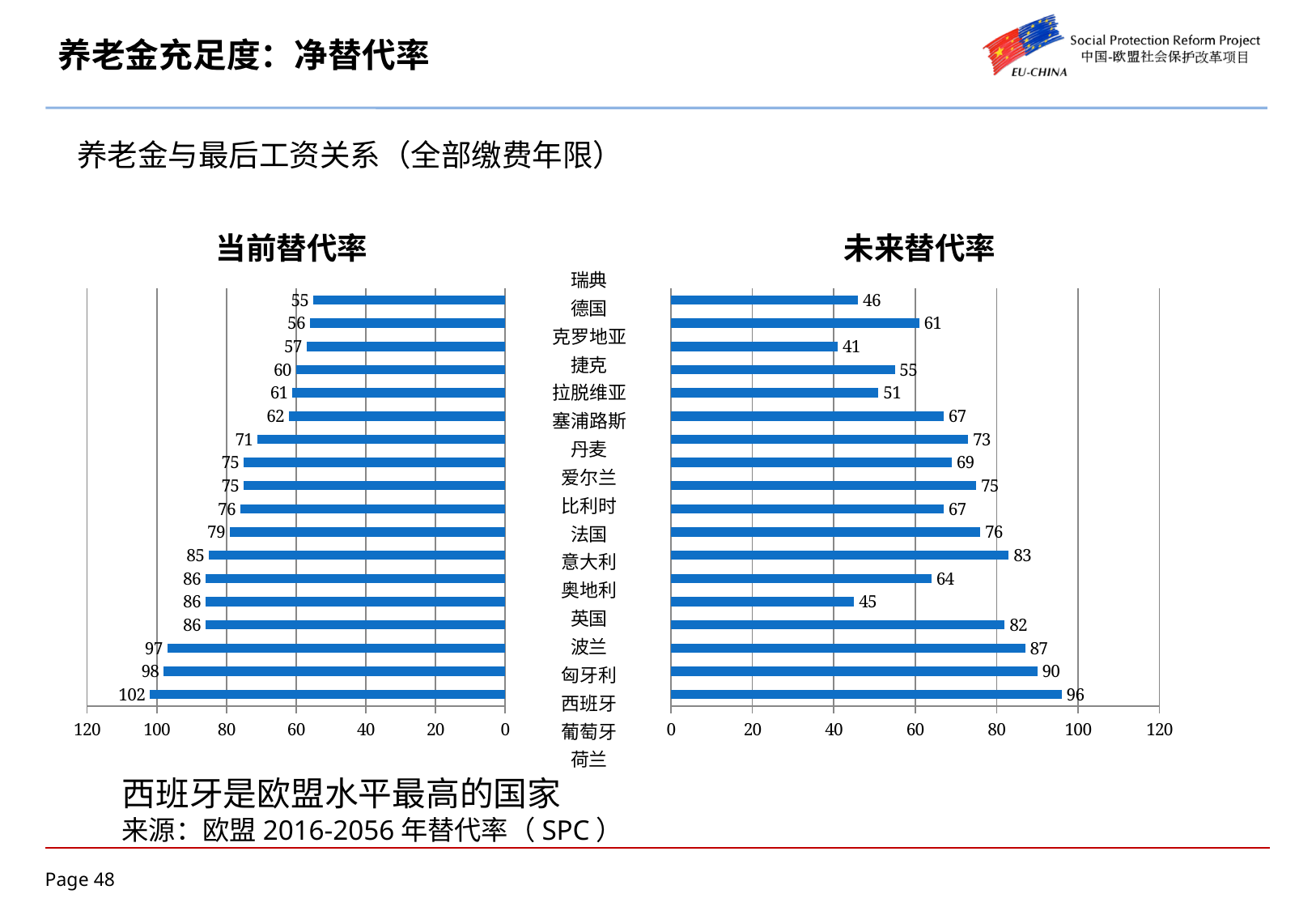
What is the maximum value shown on the horizontal axis of the 未来替代率 chart? 120 What kind of chart is the 当前替代率 chart? bar chart In the 当前替代率 chart, what is the value of the longest bar? 102 How many bars are plotted in the 未来替代率 chart? 18 Which is larger: the highest value in the 当前替代率 chart or the highest value in the 未来替代率 chart? 当前替代率 In the 未来替代率 chart, what is the value of the shortest bar? 41 What is the difference between the highest value in the 当前替代率 chart and the highest value in the 未来替代率 chart? 6 In the 当前替代率 chart, do the bar values increase or decrease from the top bar to the bottom bar? increase In the 当前替代率 chart, what is the value of the shortest bar? 55 In the 未来替代率 chart, is the value of the longest bar greater or less than 100? less In the 当前替代率 chart, is the value of the longest bar greater or less than 100? greater In the 未来替代率 chart, what is the value of the longest bar? 96